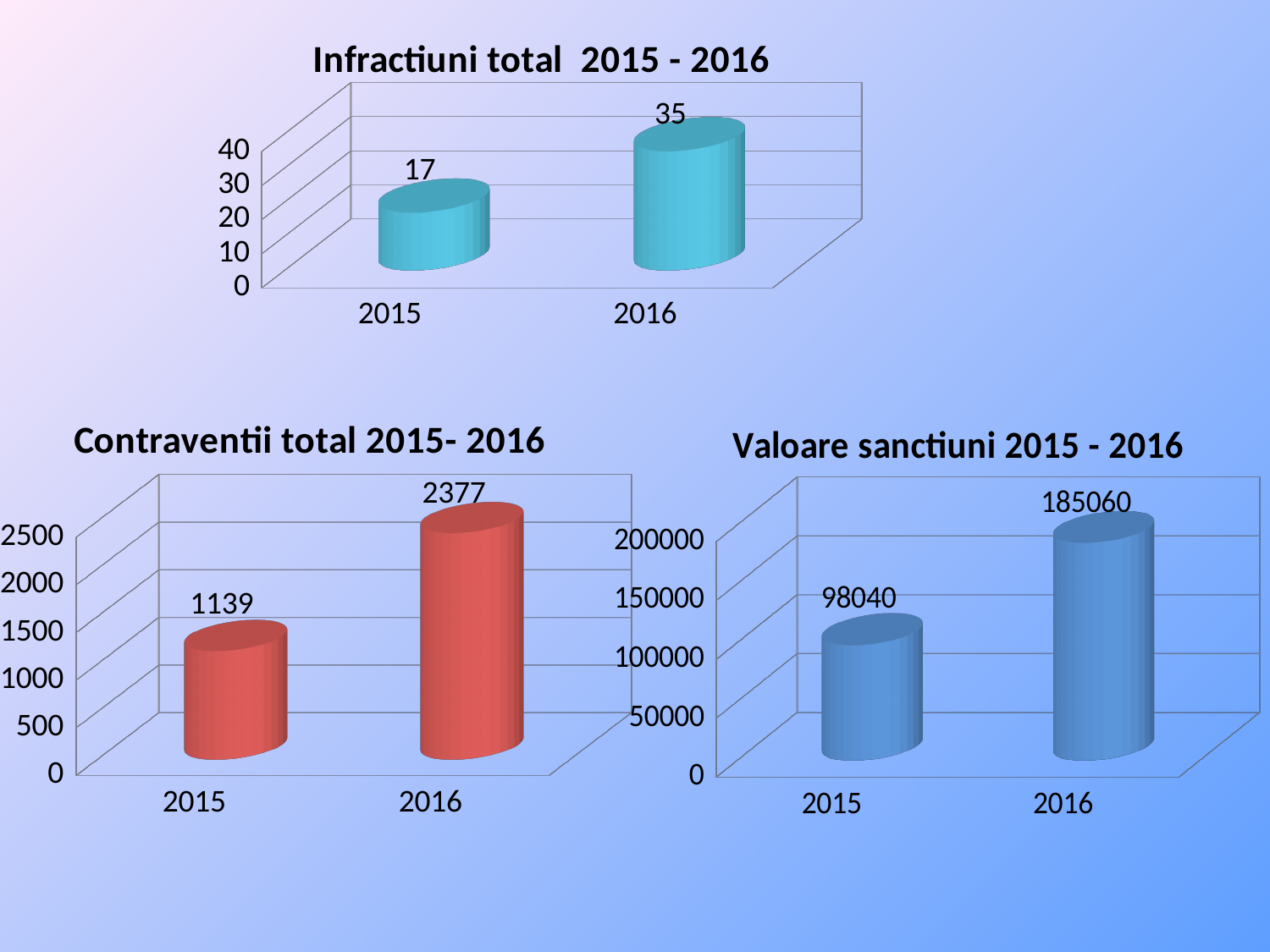
In the 'Infractiuni total 2015 - 2016' chart, what is the value for 2015? 17 How many charts are shown on the slide? 3 In the 'Infractiuni total 2015 - 2016' chart, what is the difference between the 2016 and 2015 values? 18 In the 'Valoare sanctiuni 2015 - 2016' chart, what is the value for 2015? 98040 In the 'Valoare sanctiuni 2015 - 2016' chart, what is the value for 2016? 185060 In the 'Contraventii total 2015- 2016' chart, which year has the higher value? 2016 In the 'Valoare sanctiuni 2015 - 2016' chart, which year has the lower value? 2015 In the 'Infractiuni total 2015 - 2016' chart, what is the value for 2016? 35 In the 'Contraventii total 2015- 2016' chart, what is the value for 2015? 1139 In the 'Contraventii total 2015- 2016' chart, what is the difference between the 2016 and 2015 values? 1238 In the 'Valoare sanctiuni 2015 - 2016' chart, do the values rise or fall from 2015 to 2016? rise In the 'Contraventii total 2015- 2016' chart, what is the value for 2016? 2377